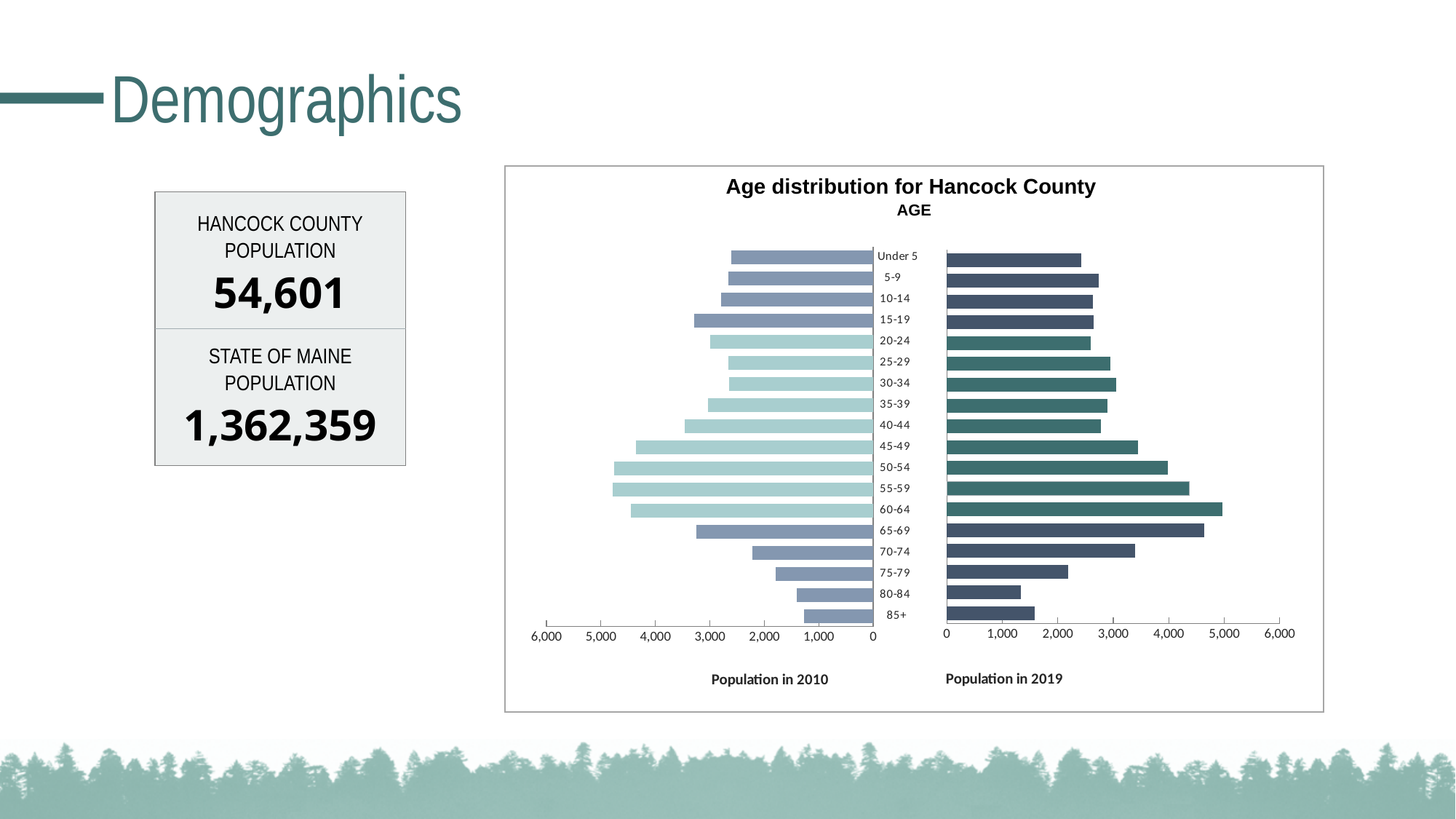
What is the title of the chart on the slide? Age distribution for Hancock County In the Age distribution for Hancock County chart, is the Population in 2010 for the 85+ age group greater or less than 2,000? less How many age groups are shown in the Age distribution for Hancock County chart? 18 What kind of chart is used to show the age distribution for Hancock County? bar chart In the Age distribution for Hancock County chart, which age group has the highest Population in 2019? 60-64 In the Age distribution for Hancock County chart, is the Population in 2019 for the Under 5 age group greater or less than 3,000? less In the Age distribution for Hancock County chart, which age group has the larger Population in 2019: 55-59 or 80-84? 55-59 In the Age distribution for Hancock County chart, is the Population in 2019 for the 60-64 age group greater or less than 4,000? greater How many population series (years) does the Age distribution for Hancock County chart show? 2 In the Age distribution for Hancock County chart, which is larger for the 65-69 age group: Population in 2010 or Population in 2019? Population in 2019 What label is shown above the age group categories in the Age distribution for Hancock County chart? AGE